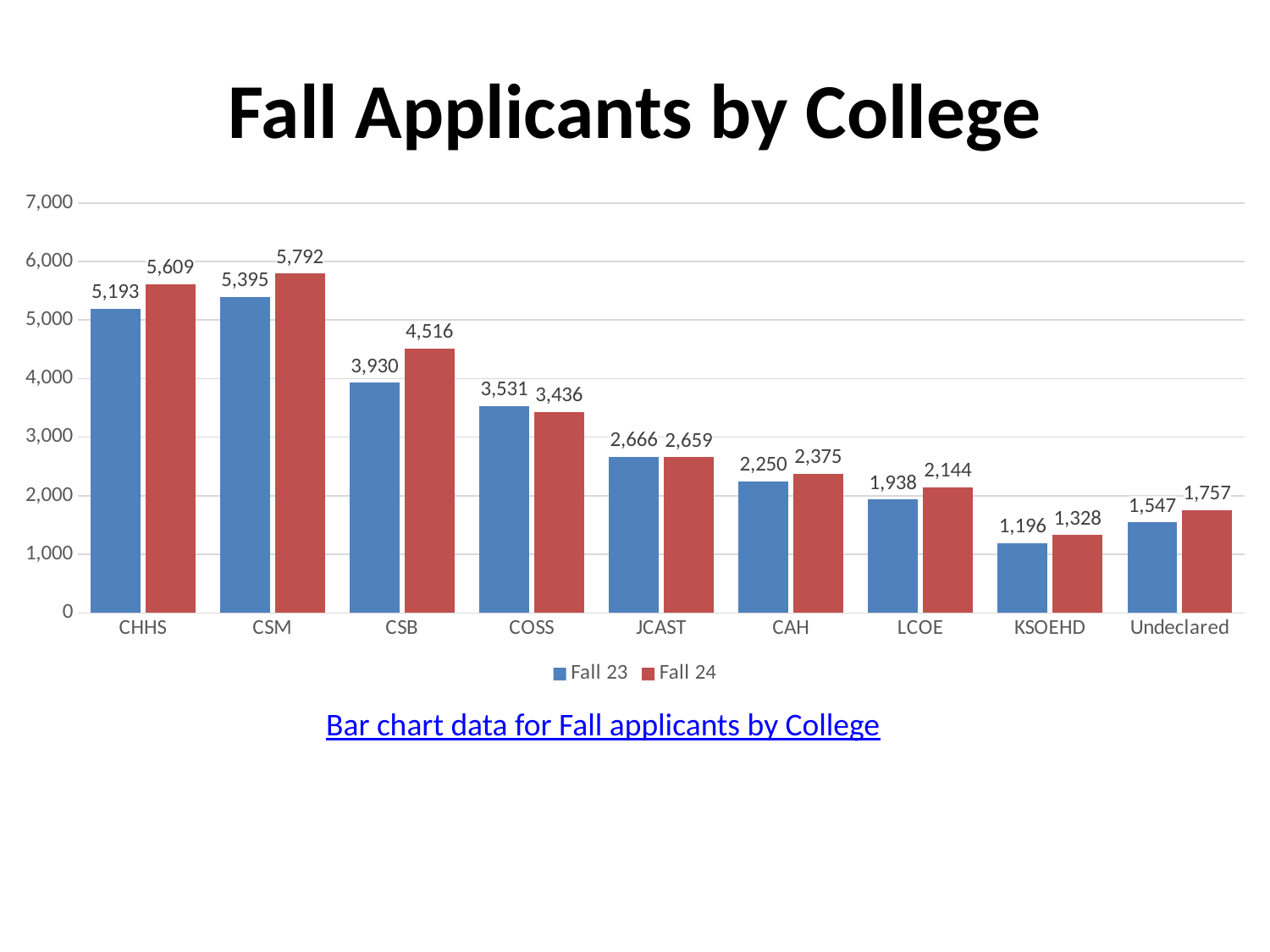
Which is larger for COSS, the Fall 23 value or the Fall 24 value? Fall 23 How many colleges (categories) are shown on the x axis? 9 What is the Fall 23 value for LCOE? 1,938 How many series does the legend list? 2 What colour are the Fall 24 bars? Red What kind of chart is shown on the slide? Bar chart Which college has the highest Fall 24 value? CSM Which college has the lowest Fall 23 value? KSOEHD What is the title of the chart? Fall Applicants by College What is the difference between the Fall 24 and Fall 23 values for CHHS? 416 What is the Fall 24 value for CSB? 4,516 Is the Fall 24 value for CAH greater or less than 2,000? greater